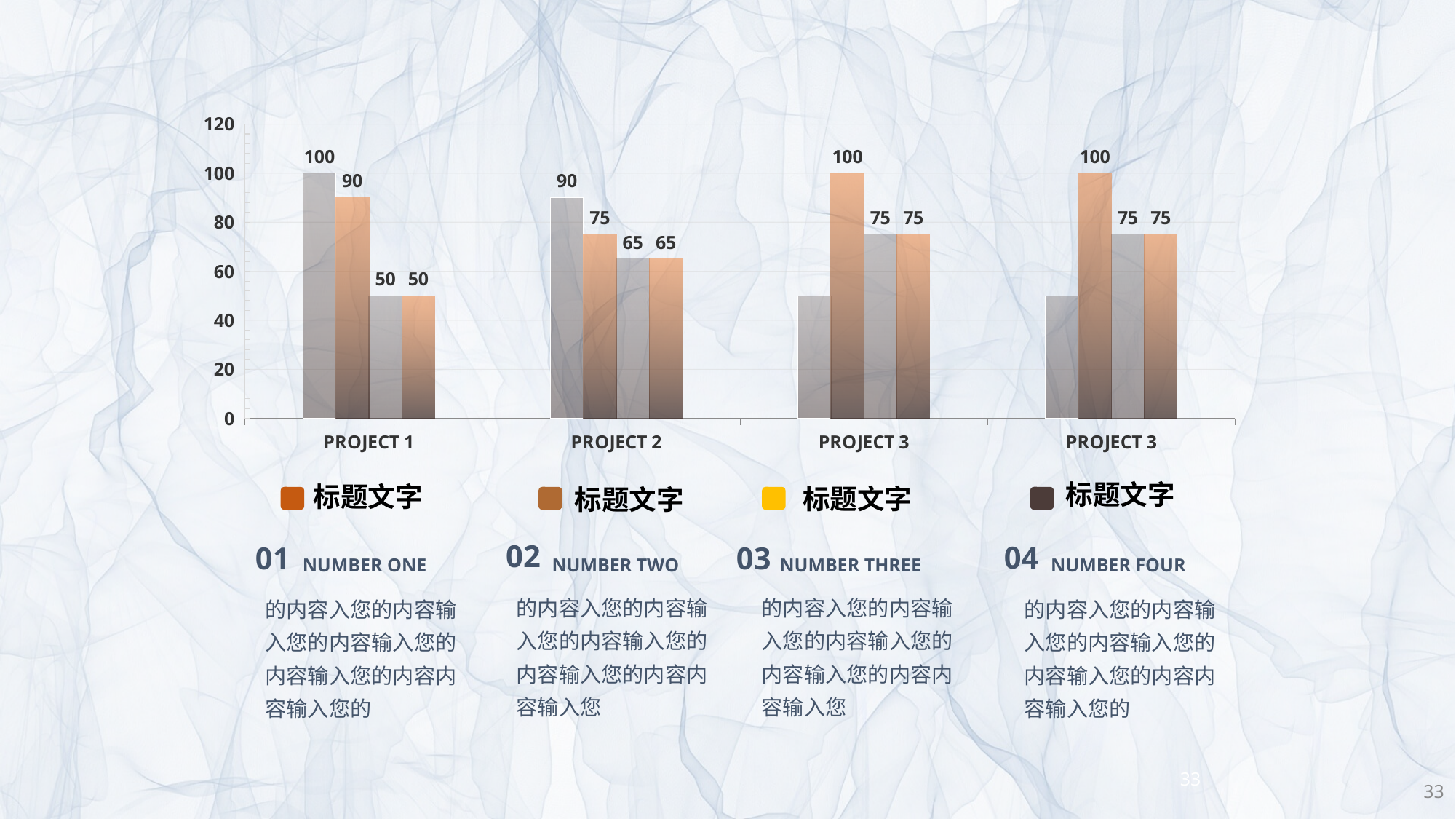
Which bar in the PROJECT 2 group has the highest value? the first bar (90) What is the label of the first category on the x axis? PROJECT 1 How many categories are shown along the x axis of the chart? 4 What is the value of the first (leftmost) bar in the PROJECT 1 group? 100 How many bars are plotted for each category in the chart? 4 Is the value of the first (unlabeled) bar in the third category from the left greater or less than 60? less What is the value of the second bar in the PROJECT 2 group? 75 What kind of chart is shown on the slide? bar chart What is the difference between the first bar (90) and the fourth bar (65) in the PROJECT 2 group? 25 What is the value of the fourth bar in the PROJECT 1 group? 50 Which is larger: the third bar in the PROJECT 1 group or the third bar in the PROJECT 2 group? the third bar in the PROJECT 2 group What is the difference between the first bar (100) and the second bar (90) in the PROJECT 1 group? 10